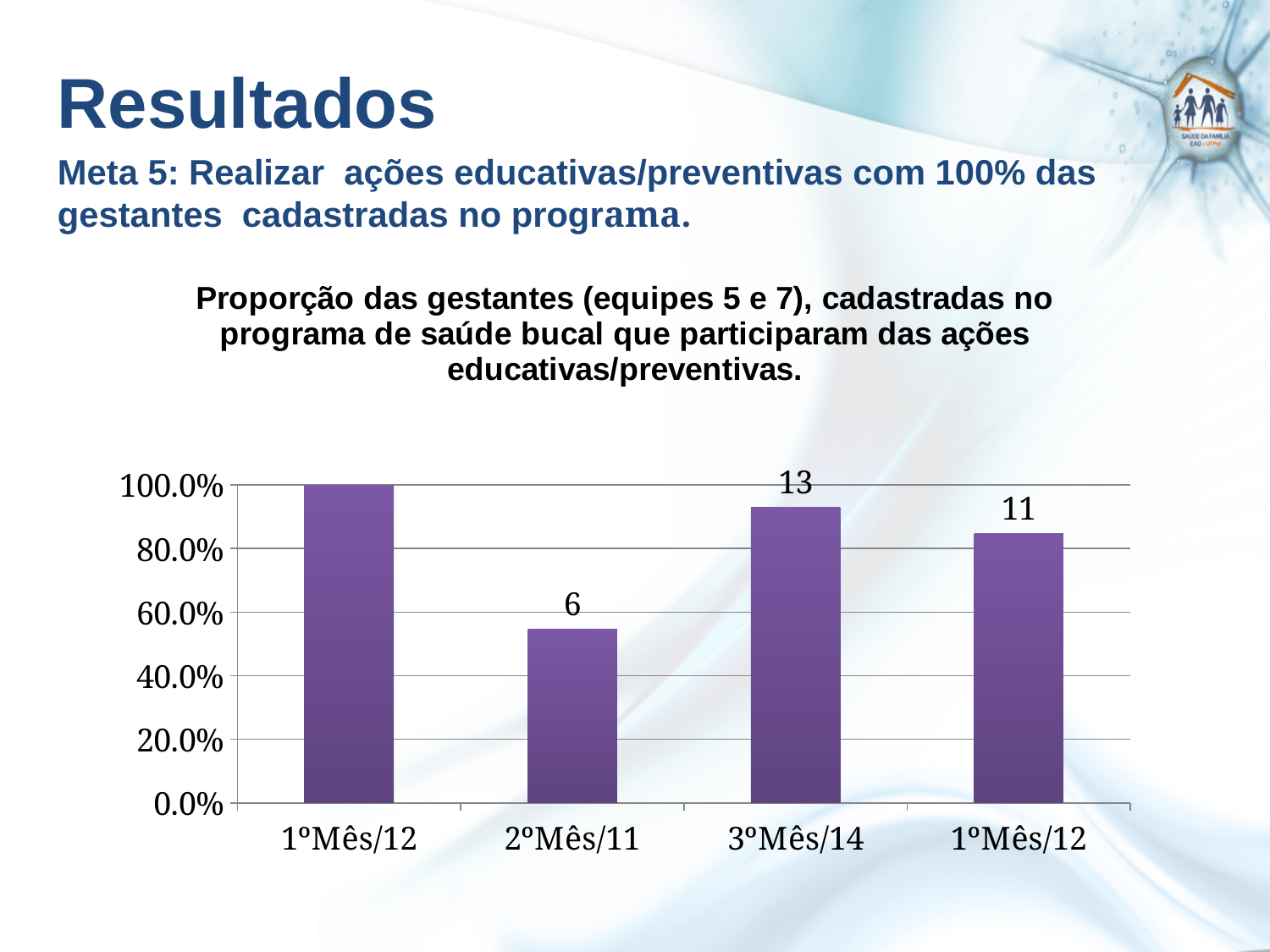
What percentage does the first bar (1ºMês/12) reach on the y axis? 100.0% Which category has the shortest bar? 2ºMês/11 Which category has the tallest bar? 1ºMês/12 What is the highest value shown on the y axis? 100.0% What data label is printed above the bar for 2ºMês/11? 6 Which bar is taller, 3ºMês/14 or 2ºMês/11? 3ºMês/14 Is the bar for 3ºMês/14 greater or less than 80.0%? greater How many bars are plotted in the chart? 4 What data label is printed above the last bar on the right (1ºMês/12)? 11 Is the bar for 2ºMês/11 greater or less than 60.0%? less What data label is printed above the bar for 3ºMês/14? 13 What type of chart is shown on the slide? bar chart